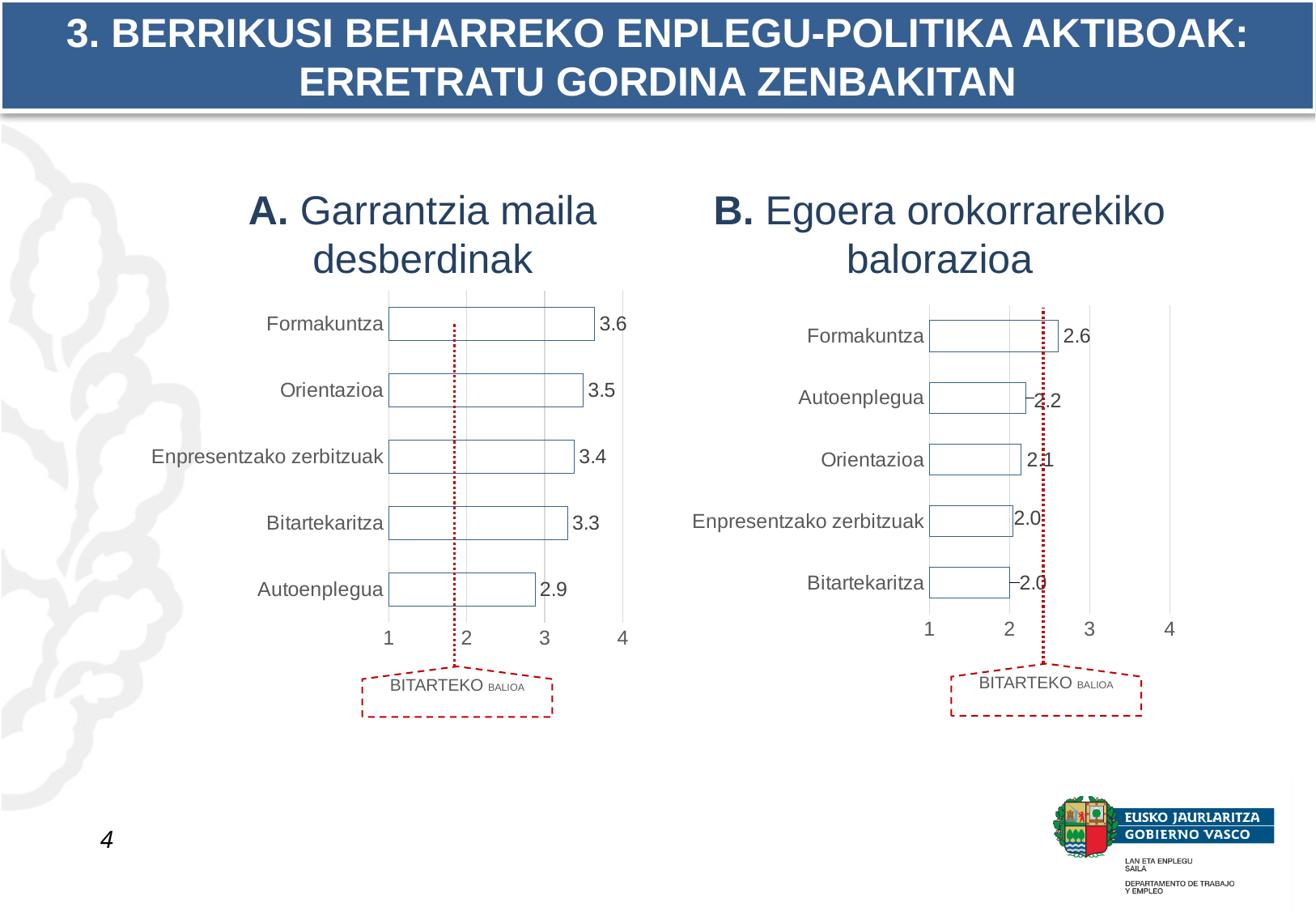
Which is larger: the value for Orientazioa in chart A or the value for Orientazioa in chart B? Chart A (3.5) In chart A (Garrantzia maila desberdinak), what is the difference between the values for Formakuntza and Autoenplegua? 0.7 In chart A (Garrantzia maila desberdinak), which category has the lowest value? Autoenplegua In chart A (Garrantzia maila desberdinak), what is the value for Autoenplegua? 2.9 In chart A (Garrantzia maila desberdinak), how many categories are shown? 5 In chart B (Egoera orokorrarekiko balorazioa), which category has the highest value? Formakuntza In chart A (Garrantzia maila desberdinak), which category has the highest value? Formakuntza In chart B (Egoera orokorrarekiko balorazioa), what is the value for Autoenplegua? 2.2 In chart B (Egoera orokorrarekiko balorazioa), what is the value for Formakuntza? 2.6 In chart B (Egoera orokorrarekiko balorazioa), is the value for Bitartekaritza greater or less than 3? less What kind of chart is chart A (Garrantzia maila desberdinak)? Bar chart In chart A (Garrantzia maila desberdinak), what is the value for Formakuntza? 3.6